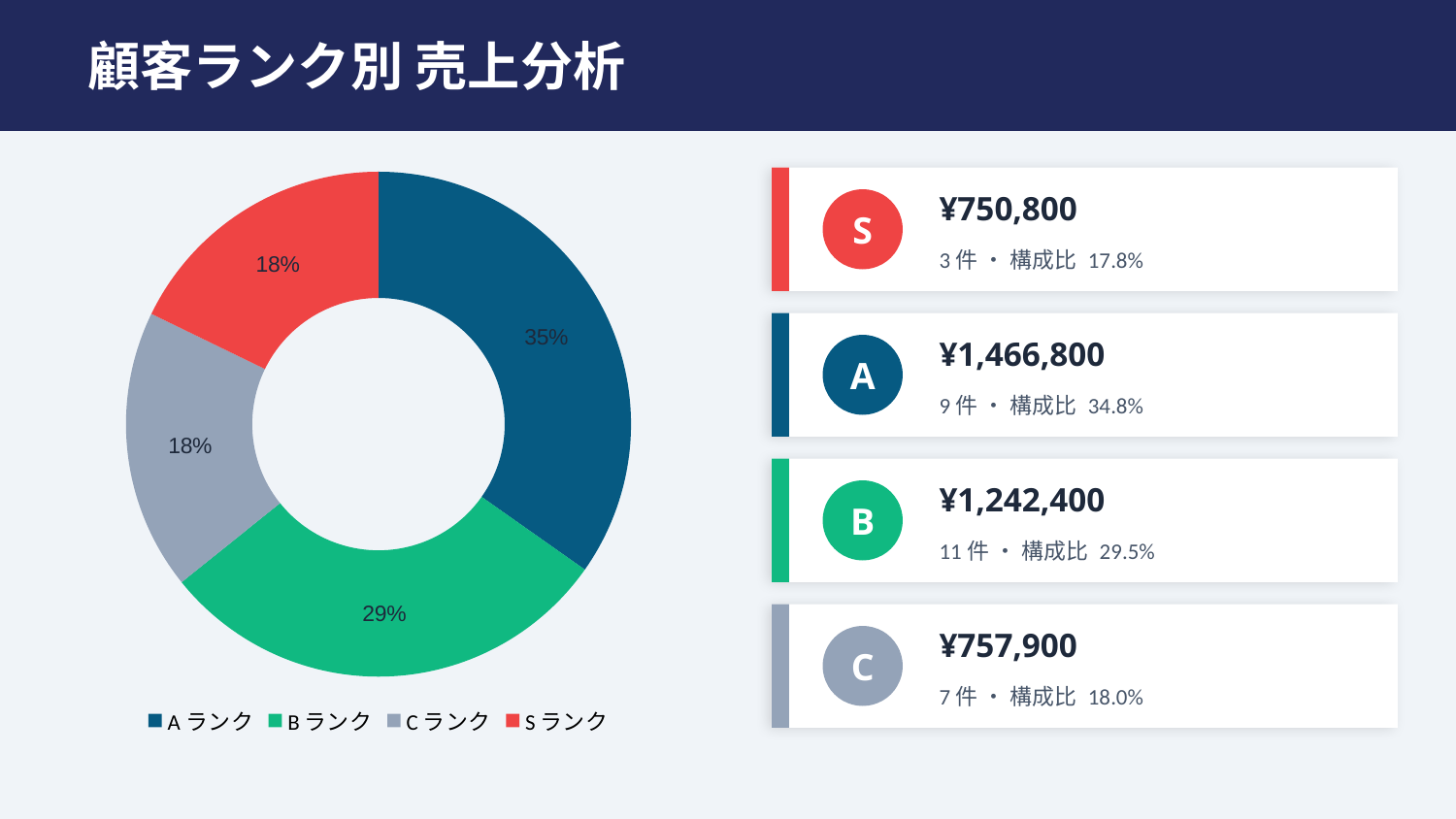
What percentage share does the C ランク slice have in the pie chart? 18% What percentage share does the A ランク slice have in the pie chart? 35% Which category has the largest slice in the pie chart? A ランク What colour is the S ランク slice in the pie chart? Red What kind of chart is shown on the slide? Pie chart (donut) What percentage share does the B ランク slice have in the pie chart? 29% What percentage share does the S ランク slice have in the pie chart? 18% How many slices does the pie chart have? 4 What is the difference in percentage points between the A ランク slice and the B ランク slice? 6 What is the title of the slide containing the pie chart? 顧客ランク別 売上分析 Which slice is larger in the pie chart, B ランク or C ランク? B ランク How many entries does the legend of the pie chart list? 4